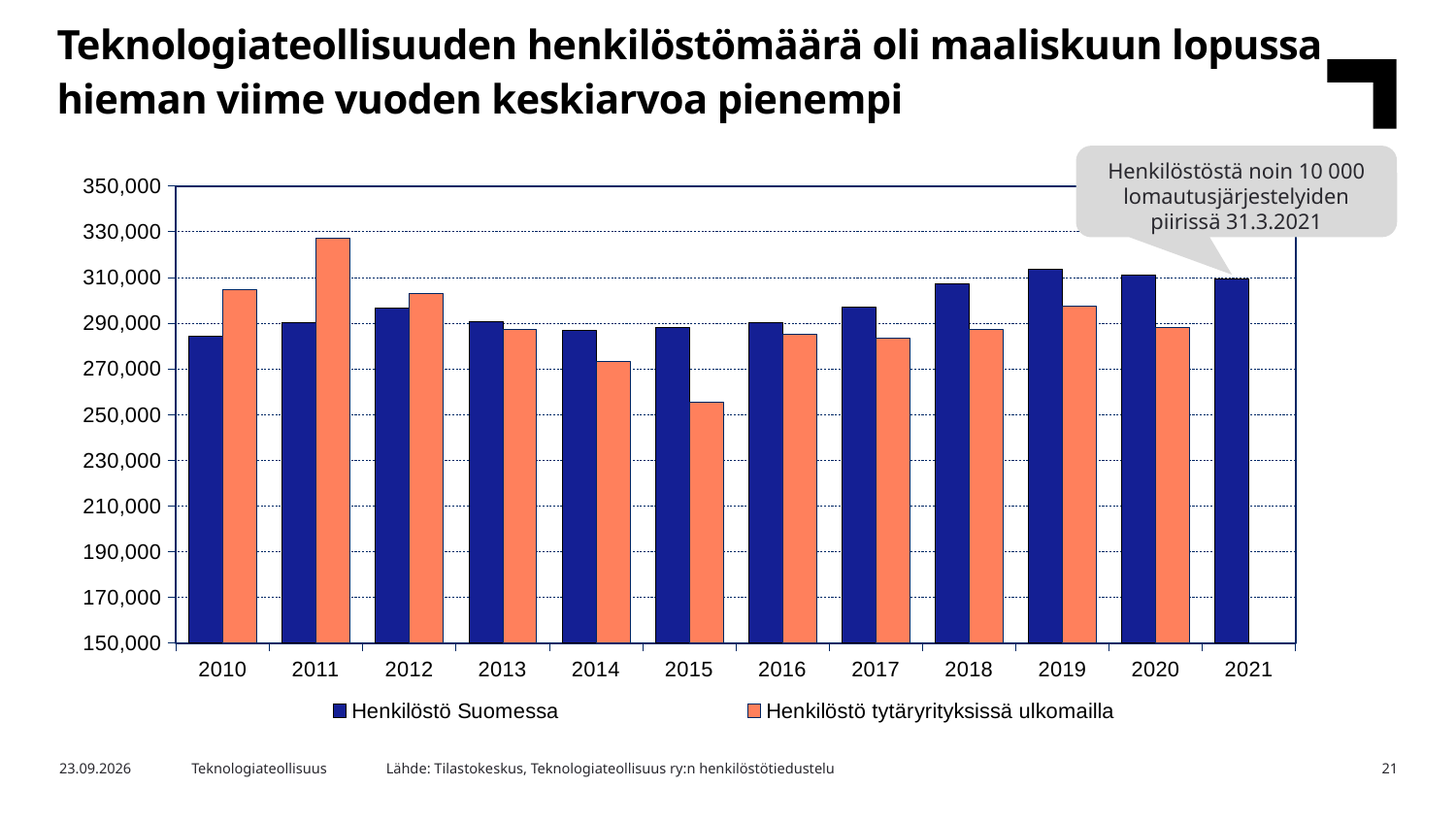
Is the value for Henkilöstö tytäryrityksissä ulkomailla in 2015 greater or less than 270,000? less Is the value for Henkilöstö tytäryrityksissä ulkomailla in 2011 greater or less than 310,000? greater Which series is shown in dark blue? Henkilöstö Suomessa In 2015, which is larger: Henkilöstö Suomessa or Henkilöstö tytäryrityksissä ulkomailla? Henkilöstö Suomessa What kind of chart is shown on the slide? Bar chart Does the value for Henkilöstö Suomessa rise or fall from 2016 to 2019? rise Is the value for Henkilöstö Suomessa in 2018 greater or less than 290,000? greater In which year is the value for Henkilöstö tytäryrityksissä ulkomailla lowest? 2015 In 2011, which is larger: Henkilöstö Suomessa or Henkilöstö tytäryrityksissä ulkomailla? Henkilöstö tytäryrityksissä ulkomailla How many series does the legend list? 2 How many years are shown on the x axis? 12 In which year is the value for Henkilöstö tytäryrityksissä ulkomailla highest? 2011